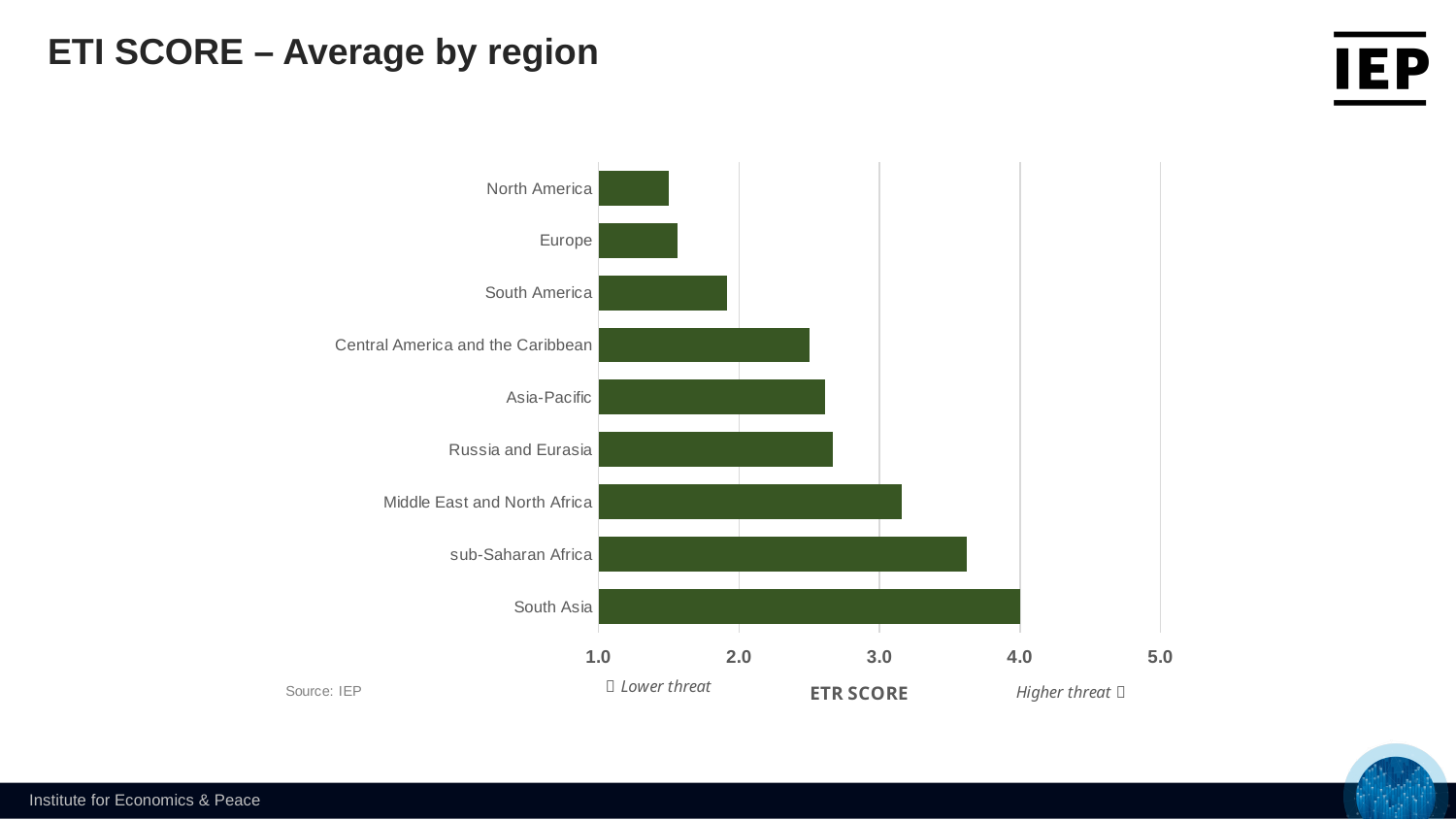
Which has the larger value, South America or Europe? South America Is the value for Central America and the Caribbean greater or less than 2.0? greater Is the value for Russia and Eurasia greater or less than 3.0? less How many regions are plotted in the chart? 9 What is the label on the horizontal axis of the chart? ETR SCORE Which region has the highest average ETI score? South Asia Is the value for sub-Saharan Africa greater or less than 3.0? greater Which has the larger value, sub-Saharan Africa or Middle East and North Africa? sub-Saharan Africa What is the title of the slide? ETI SCORE – Average by region What kind of chart is shown on the slide? Bar chart